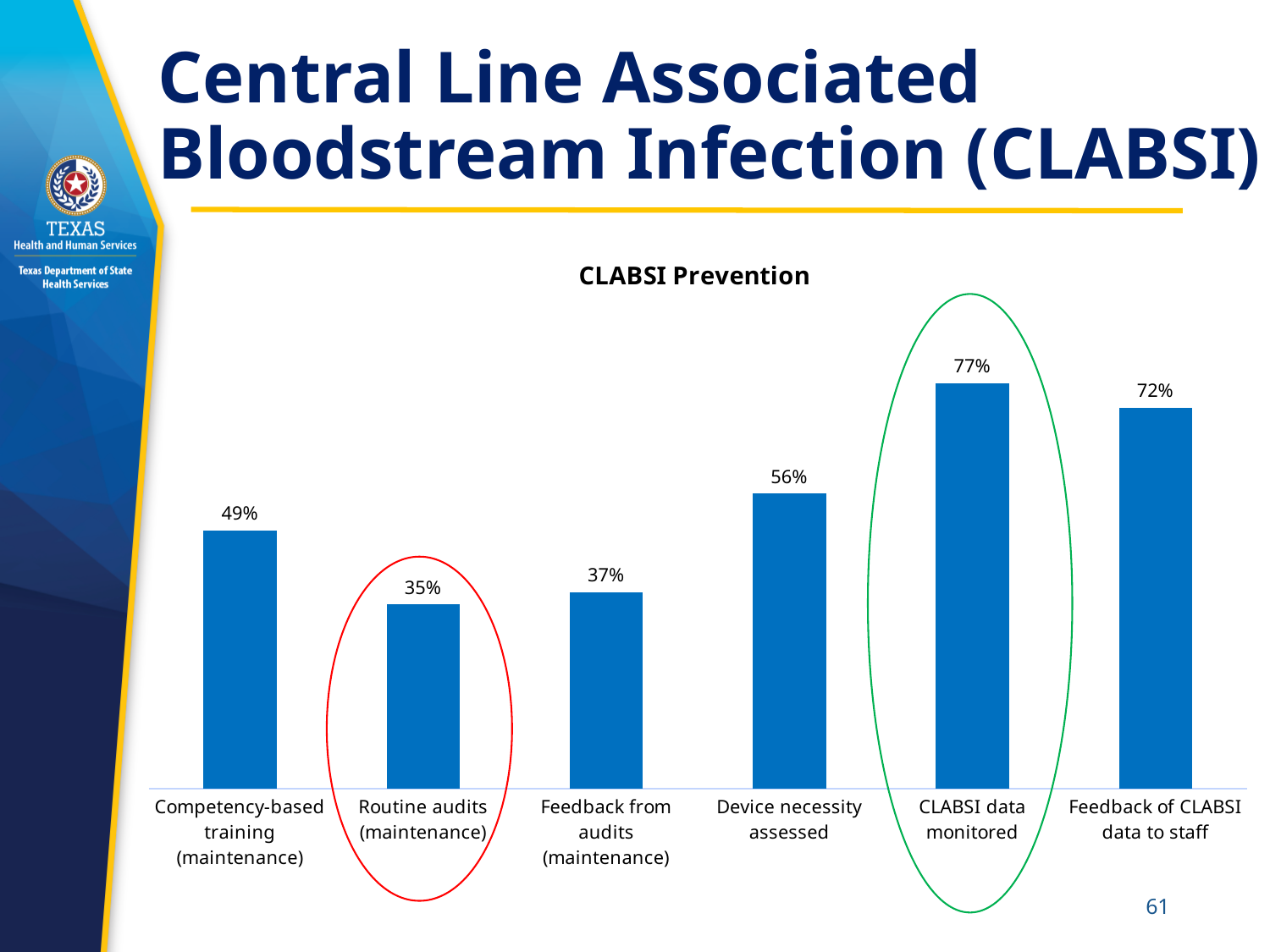
How many categories are shown in the chart? 6 Which category has the lowest value? Routine audits (maintenance) What is the title of the chart? CLABSI Prevention Which category has the highest value? CLABSI data monitored What is the difference between CLABSI data monitored and Routine audits (maintenance)? 42% Which category is circled in red? Routine audits (maintenance) What is the value for Competency-based training (maintenance)? 49% Which is larger, Competency-based training (maintenance) or Feedback from audits (maintenance)? Competency-based training (maintenance) What is the value for Feedback of CLABSI data to staff? 72% What kind of chart is shown? Bar chart What is the value for Device necessity assessed? 56% What is the difference between Feedback of CLABSI data to staff and Device necessity assessed? 16%